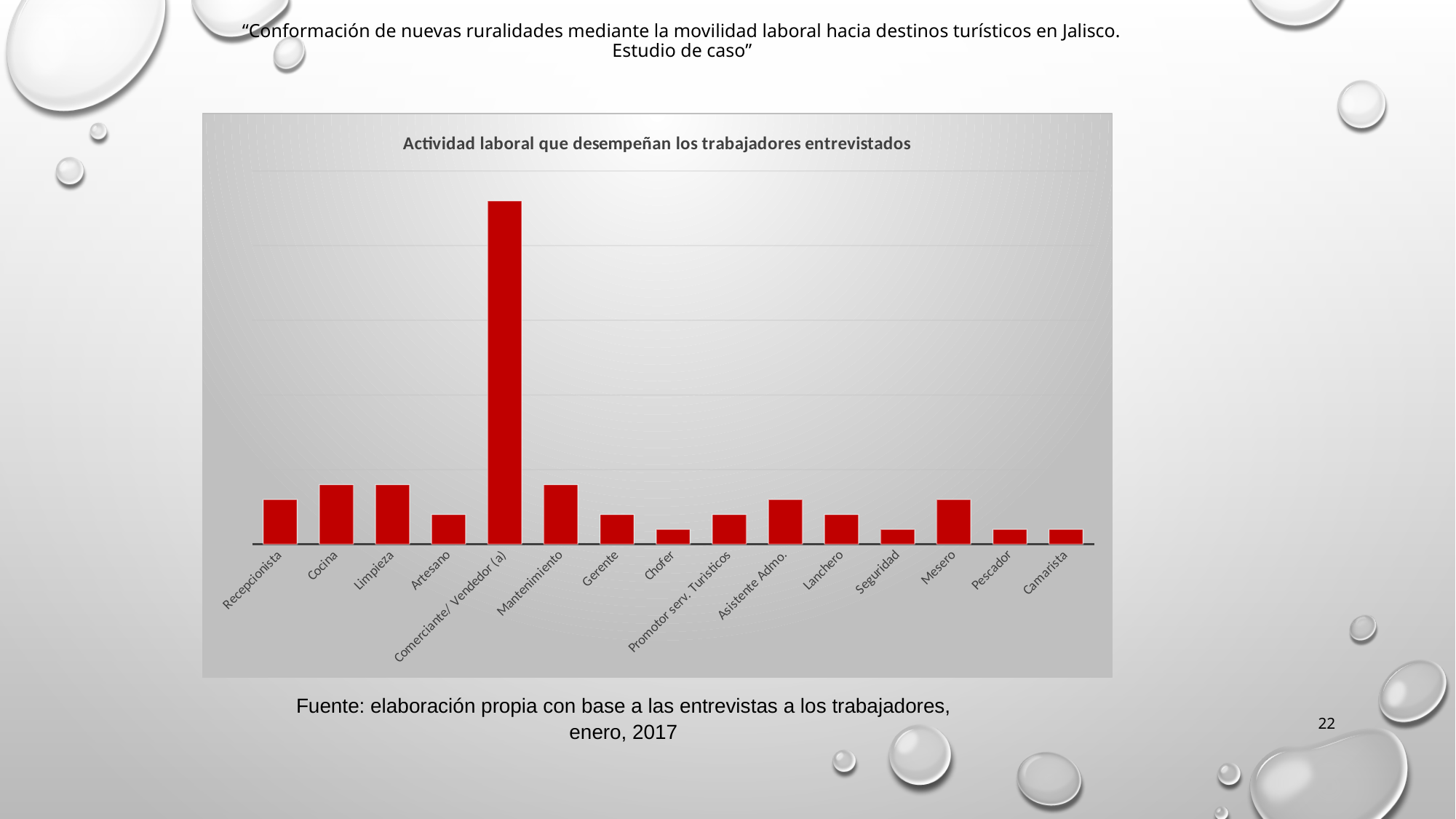
Which is larger, the value for Cocina or the value for Artesano? Cocina Which is larger, the value for Comerciante/ Vendedor (a) or the value for Recepcionista? Comerciante/ Vendedor (a) Which is larger, the value for Mesero or the value for Seguridad? Mesero What colour are the bars in the chart? red What is the title of the chart? Actividad laboral que desempeñan los trabajadores entrevistados What kind of chart is shown on the slide? bar chart Which activity has the highest bar in the chart? Comerciante/ Vendedor (a) How many categories (activities) are shown on the x axis of the chart? 15